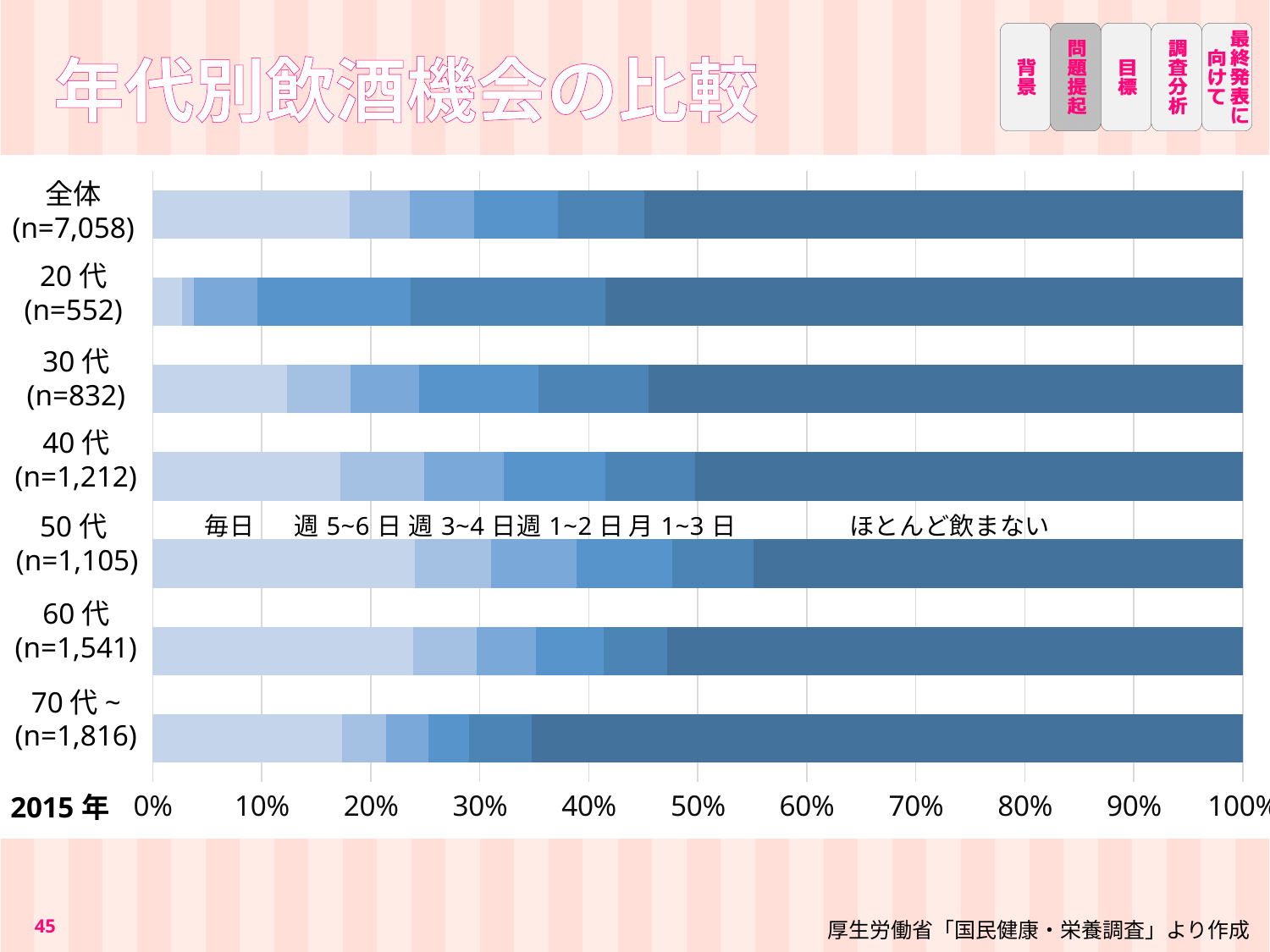
How many age-group categories (bars) are plotted in the chart? 7 Is the ほとんど飲まない value for 20代 greater or less than 50%? greater Is the 毎日 value for 50代 greater or less than 20%? greater Which age group has the smallest 毎日 (every day) segment? 20代 (n=552) Which has the larger 毎日 segment, 30代 or 40代? 40代 Which age group has the smallest ほとんど飲まない segment? 50代 (n=1,105) What is the title of the chart on the slide? 年代別飲酒機会の比較 What kind of chart is shown on the slide? stacked bar chart Which age group has the largest ほとんど飲まない segment? 70代~ (n=1,816) How many series does the chart's legend list? 6 Is the 毎日 value for 20代 greater or less than 10%? less